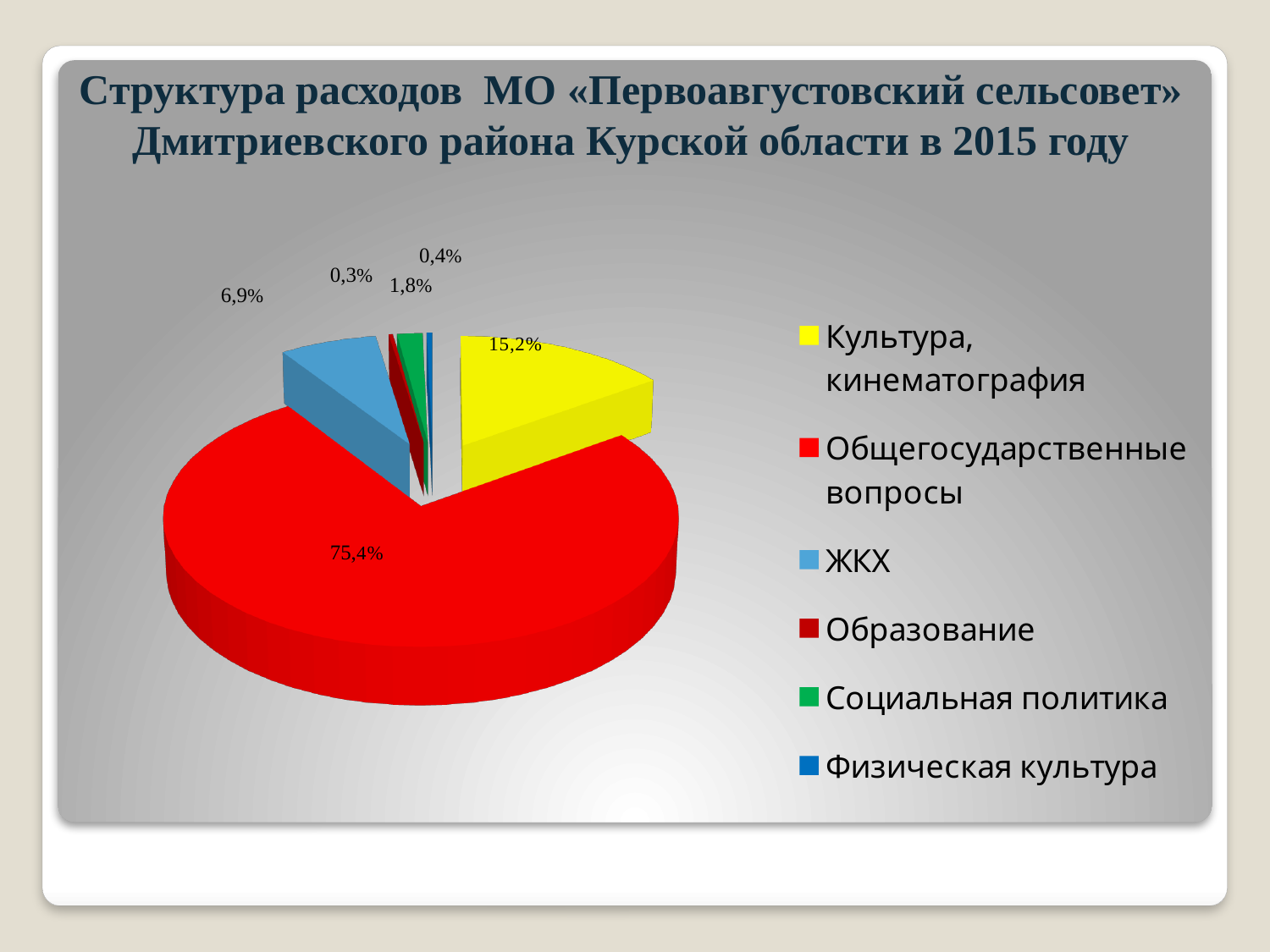
What colour is the slice for ЖКХ? light blue Which category has the largest share of expenditures? Общегосударственные вопросы Which is larger: the share for Культура, кинематография or the share for ЖКХ? Культура, кинематография What is the difference between the share for Общегосударственные вопросы and the share for Культура, кинематография? 60,2% What share of expenditures goes to Культура, кинематография? 15,2% What share of expenditures goes to Общегосударственные вопросы? 75,4% What share of expenditures goes to ЖКХ? 6,9% What share of expenditures goes to Социальная политика? 1,8% Which year does the chart title refer to? 2015 What type of chart is shown on the slide? pie chart How many categories does the legend list? 6 Which category has the smallest share of expenditures? Образование